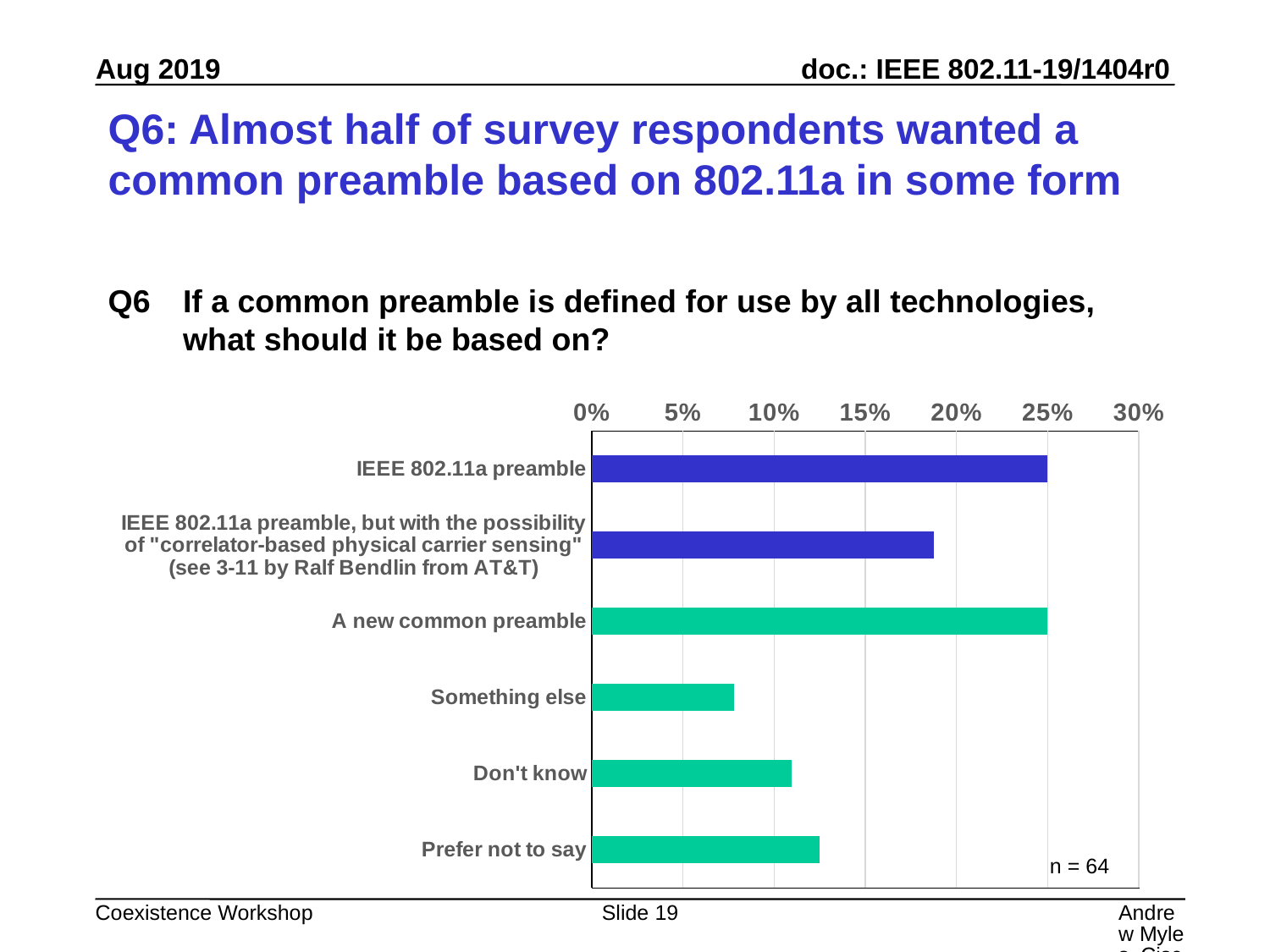
What sample size (n) is noted on the chart? n = 64 Which is larger: the value for "Don't know" or the value for "Something else"? Don't know Is the value for "Prefer not to say" greater or less than 15%? less Is the value for "Don't know" greater or less than 10%? greater Which category has the lowest value in the chart? Something else Which is larger: the value for "A new common preamble" or the value for "Prefer not to say"? A new common preamble Is the value for "IEEE 802.11a preamble, but with the possibility of 'correlator-based physical carrier sensing'" greater or less than 20%? less What kind of chart is shown on the slide? bar chart How many categories (answer options) are plotted in the chart? 6